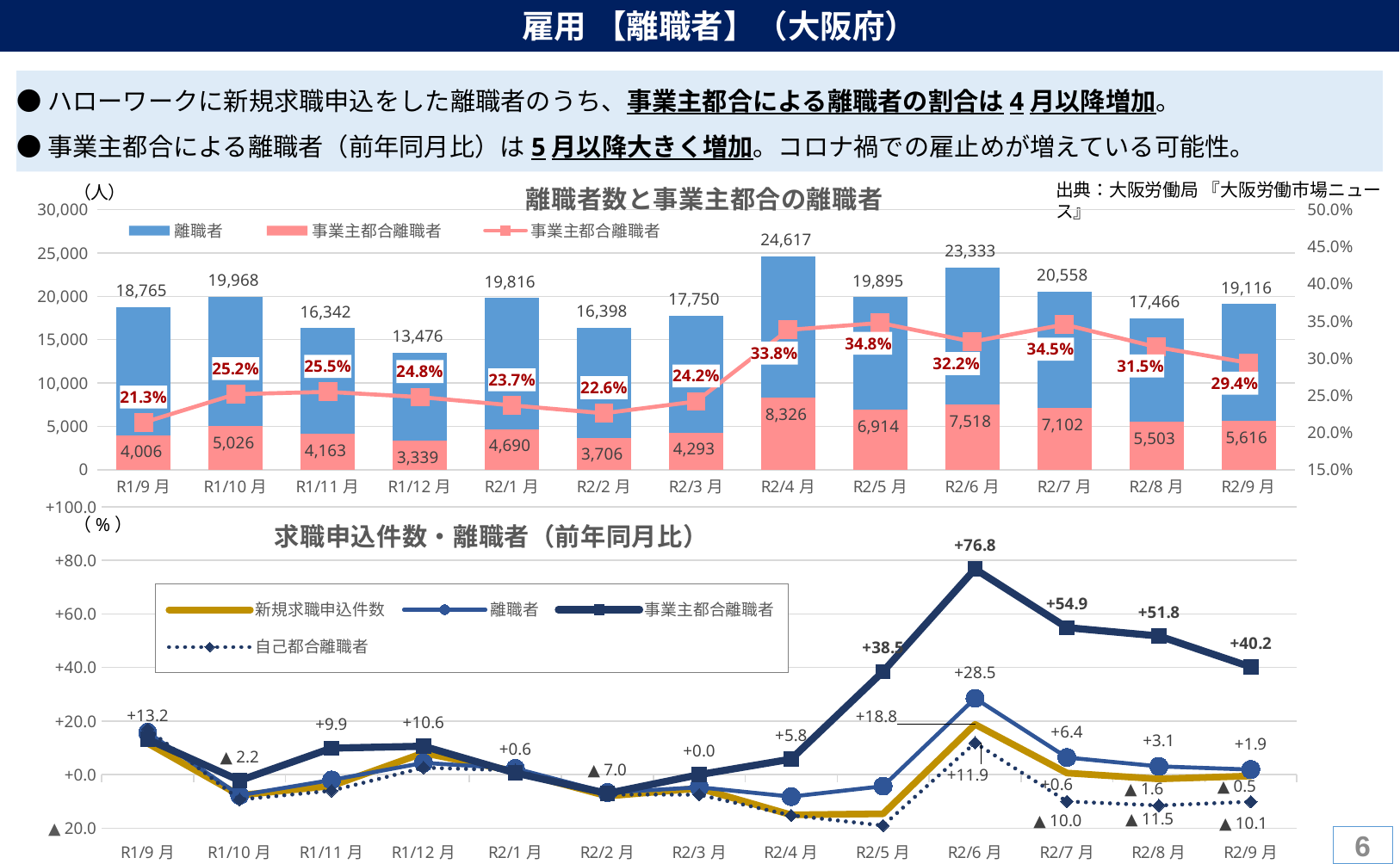
In the top chart '離職者数と事業主都合の離職者', what is the lowest percentage shown on the line? 21.3% In the top chart '離職者数と事業主都合の離職者', what is the difference between the 離職者 values for R2/6月 and R2/7月? 2,775 In the top chart '離職者数と事業主都合の離職者', which month has the highest 離職者 value? R2/4月 In the bottom chart '求職申込件数・離職者（前年同月比）', what is the value of 事業主都合離職者 for R2/6月? +76.8 In the top chart '離職者数と事業主都合の離職者', which is larger: the 事業主都合離職者 bar for R2/4月 or for R2/6月? R2/4月 In the top chart '離職者数と事業主都合の離職者', which month has the lowest 事業主都合離職者 bar value? R1/12月 In the top chart '離職者数と事業主都合の離職者', what is the value of 離職者 for R2/4月? 24,617 In the top chart '離職者数と事業主都合の離職者', how many months are shown on the x axis? 13 In the bottom chart '求職申込件数・離職者（前年同月比）', how many series does the legend list? 4 In the top chart '離職者数と事業主都合の離職者', what percentage is shown on the line for R2/5月? 34.8% In the bottom chart '求職申込件数・離職者（前年同月比）', what is the value of 離職者 for R2/9月? +1.9 In the top chart '離職者数と事業主都合の離職者', what is the value of 事業主都合離職者 (bar) for R1/12月? 3,339